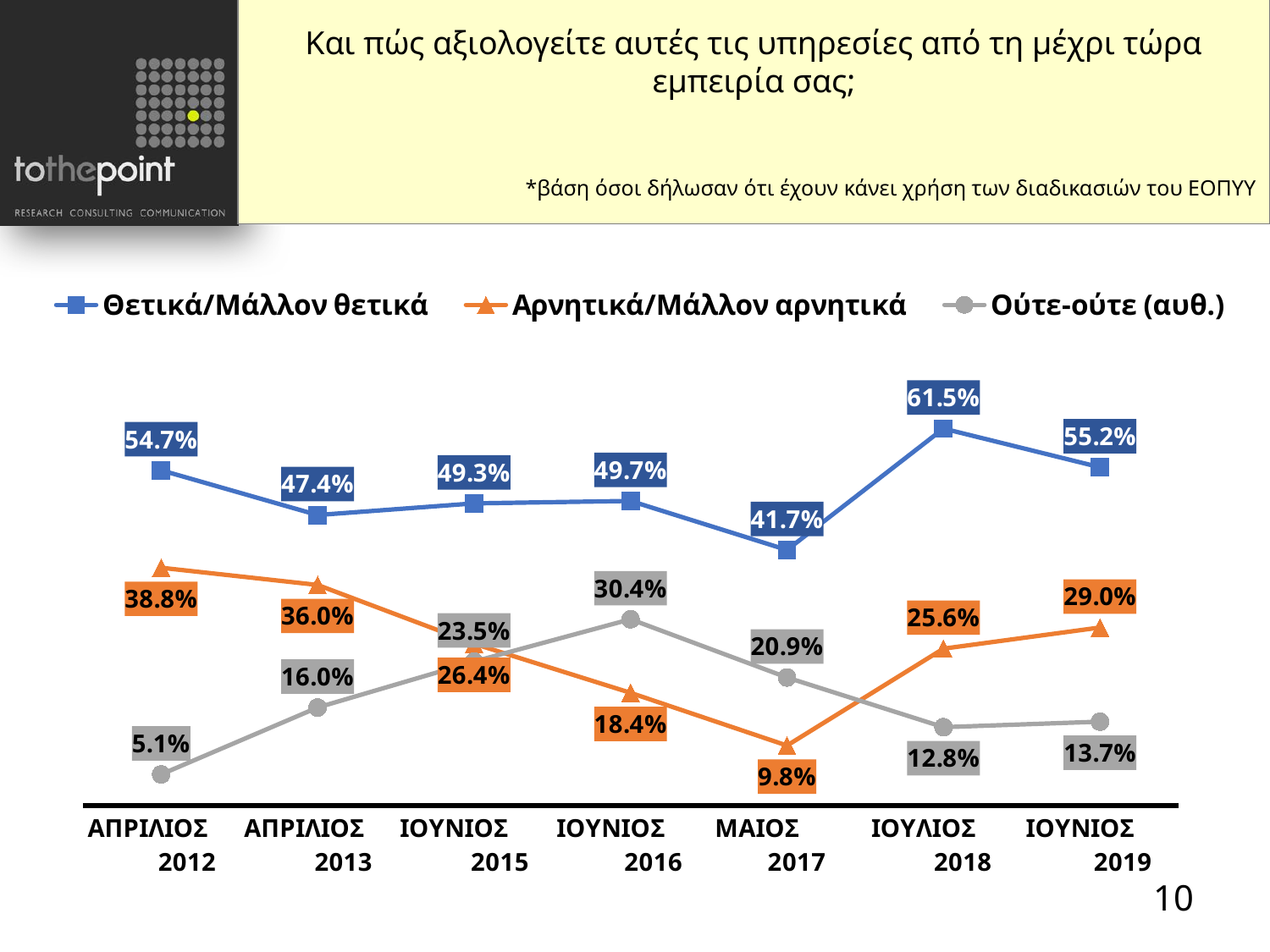
What is the value of Θετικά/Μάλλον θετικά for ΙΟΥΛΙΟΣ 2018? 61.5% In which period is Θετικά/Μάλλον θετικά at its lowest? ΜΑΙΟΣ 2017 How many time points are shown on the x axis? 7 Which series is shown with a blue line and square markers? Θετικά/Μάλλον θετικά What type of chart is shown on the slide? line chart Which is larger in ΙΟΥΝΙΟΣ 2016: Αρνητικά/Μάλλον αρνητικά or Ούτε-ούτε (αυθ.)? Ούτε-ούτε (αυθ.) What is the value of Αρνητικά/Μάλλον αρνητικά for ΜΑΙΟΣ 2017? 9.8% In which period is Ούτε-ούτε (αυθ.) at its highest? ΙΟΥΝΙΟΣ 2016 What is the difference between Θετικά/Μάλλον θετικά in ΙΟΥΛΙΟΣ 2018 and ΙΟΥΝΙΟΣ 2019? 6.3% Does Αρνητικά/Μάλλον αρνητικά rise or fall from ΑΠΡΙΛΙΟΣ 2012 to ΜΑΙΟΣ 2017? fall How many series does the legend list? 3 What is the value of Ούτε-ούτε (αυθ.) for ΑΠΡΙΛΙΟΣ 2012? 5.1%